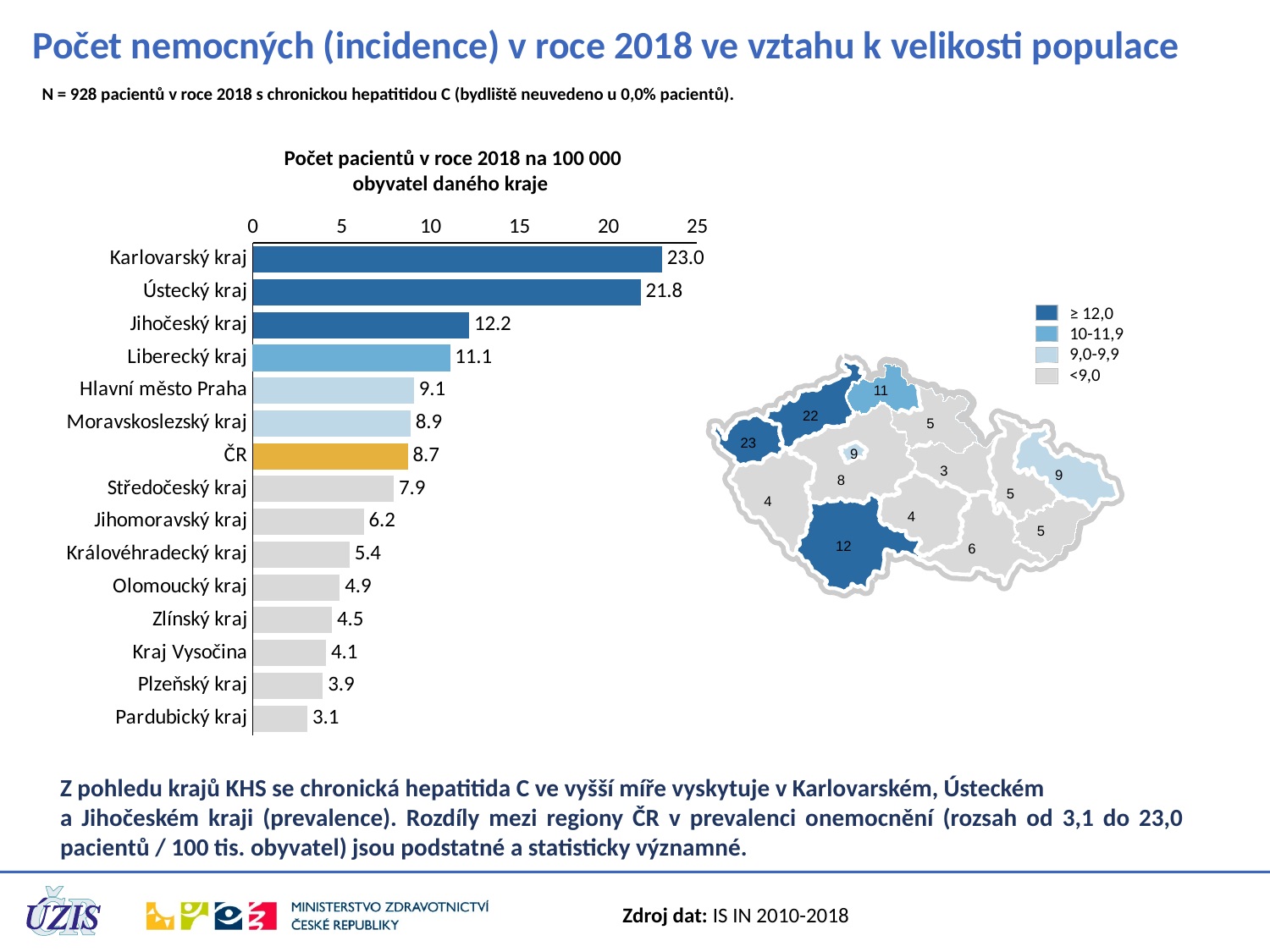
Is the value for Olomoucký kraj greater or less than 5? less Which category has the lowest value in the bar chart? Pardubický kraj Which category has the highest value in the bar chart? Karlovarský kraj What is the value for Karlovarský kraj in the bar chart? 23.0 Which is larger, the value for Středočeský kraj or the value for Jihomoravský kraj? Středočeský kraj What is the value for ČR in the bar chart? 8.7 What kind of chart is shown on the left of the slide? bar chart How many categories are shown in the bar chart? 15 What is the value for Hlavní město Praha in the bar chart? 9.1 What is the difference between the values for Karlovarský kraj and Ústecký kraj? 1.2 What is the difference between the values for Jihočeský kraj and Liberecký kraj? 1.1 What is the title of the bar chart? Počet pacientů v roce 2018 na 100 000 obyvatel daného kraje